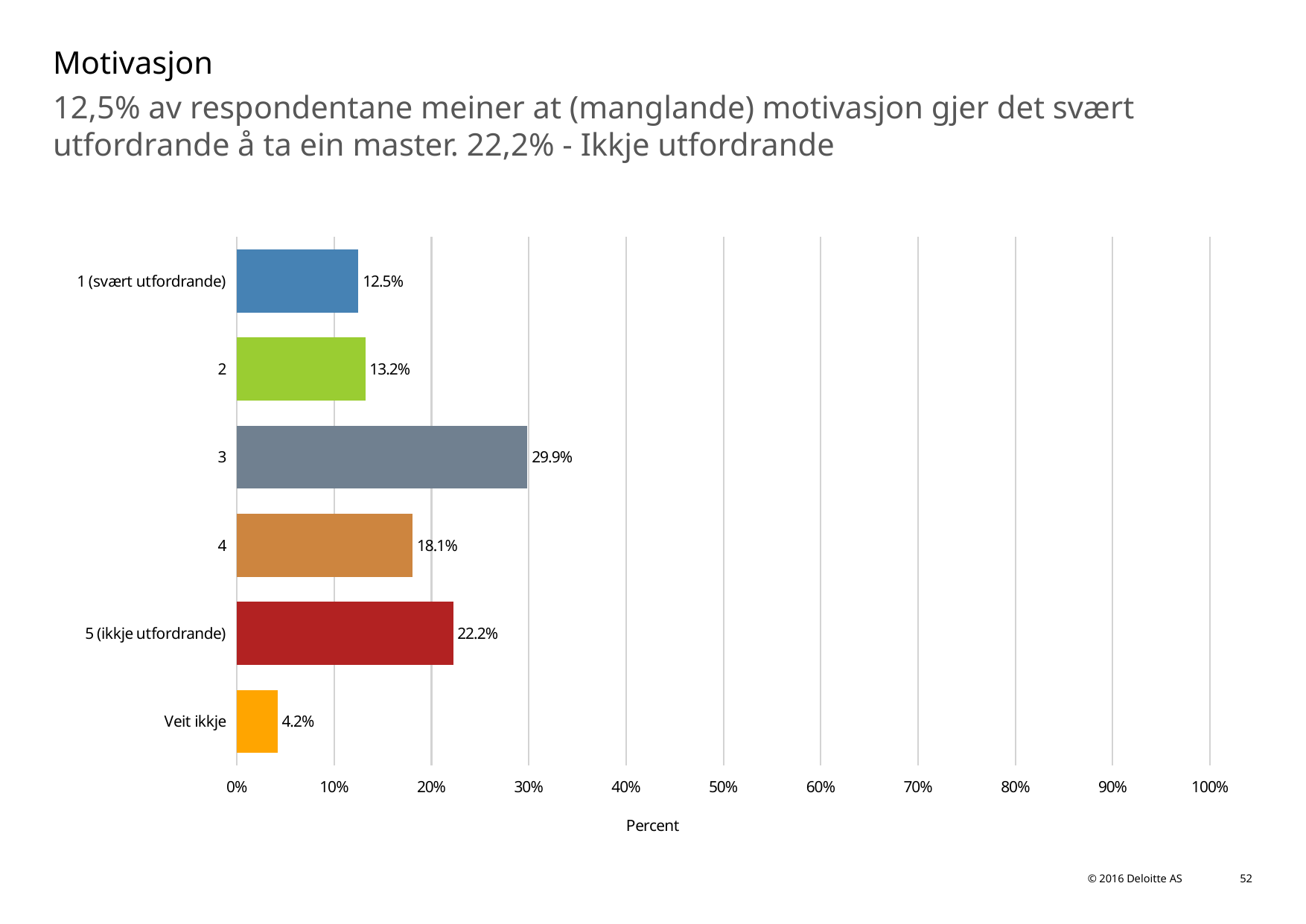
What is the value for category 3? 29.9% Is the value for category 2 greater or less than 20%? less What is the value for "5 (ikkje utfordrande)"? 22.2% Which is larger, the value for category 4 or the value for "5 (ikkje utfordrande)"? 5 (ikkje utfordrande) How many categories are shown in the chart? 6 What is the value for "Veit ikkje"? 4.2% What is the difference between the values for category 3 and category 4? 11.8% Which category has the lowest value? Veit ikkje What kind of chart is shown on the slide? bar chart Which category has the highest value? 3 What is the label of the horizontal axis? Percent What is the value for "1 (svært utfordrande)"? 12.5%